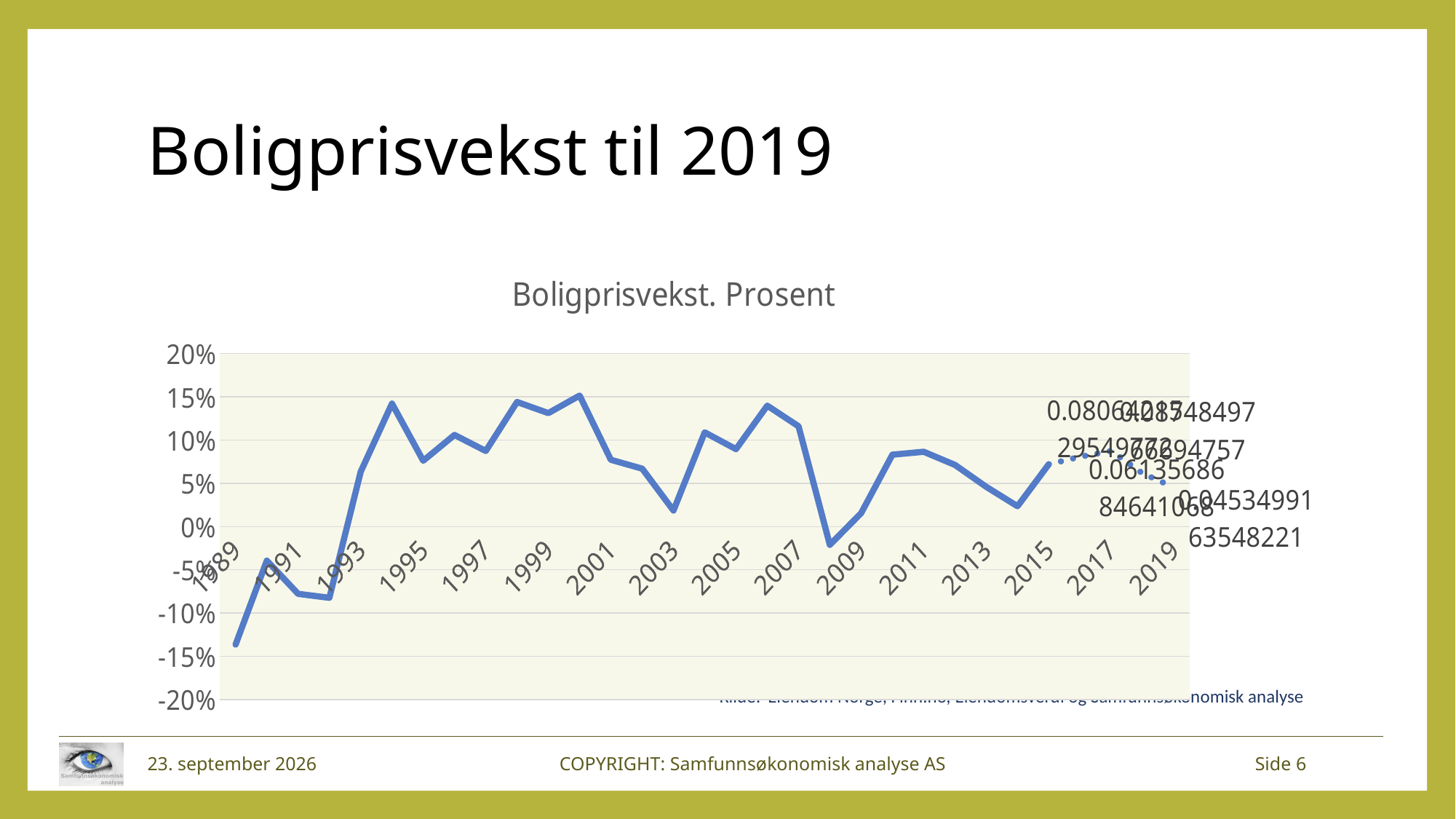
Does the line rise or fall from 2007 to 2008? fall How many year labels are shown on the x axis? 16 Is the value for 2011 greater or less than 5%? greater Is the value for 1991 greater or less than -5%? less Which year has the lowest value in the chart? 1989 Which is larger, the value for 1989 or the value for 1993? 1993 Is the value for 2000 greater or less than 10%? greater What kind of chart is shown on the slide? line chart What is the title of the chart? Boligprisvekst. Prosent